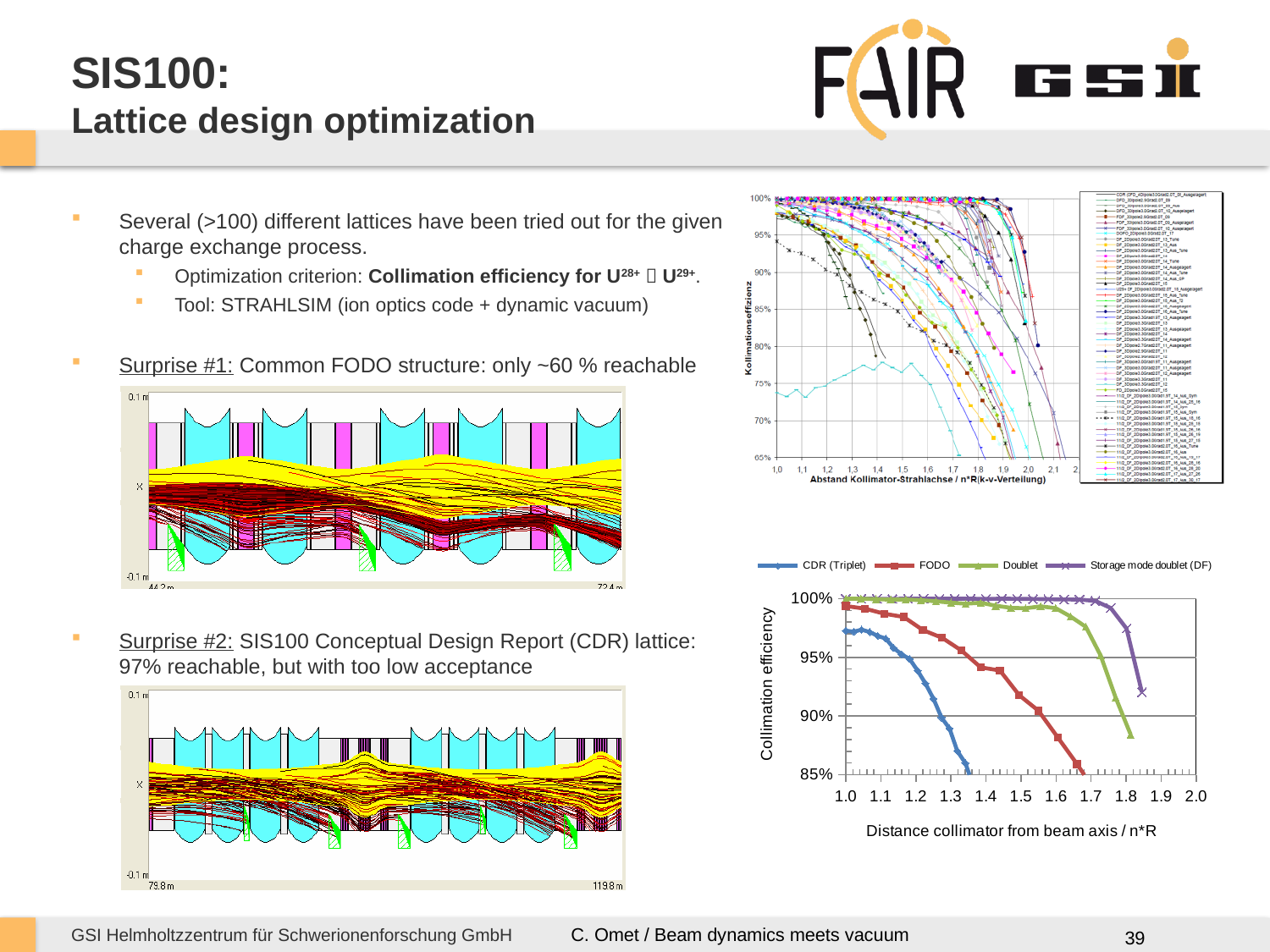
In the bottom-right chart, at a distance of 1.2, which series has the higher collimation efficiency, CDR (Triplet) or FODO? FODO In the bottom-right chart, is the collimation efficiency for FODO at a distance of 1.5 greater or less than 90%? greater In the bottom-right chart, is the collimation efficiency for Storage mode doublet (DF) at a distance of 1.8 greater or less than 95%? greater In the bottom-right chart, how many series does the legend list? 4 In the bottom-right chart, do the collimation efficiency values rise or fall as the distance from the beam axis increases? fall In the bottom-right chart, at a distance of 1.5, which series has the higher collimation efficiency, FODO or Doublet? Doublet In the bottom-right chart, is the collimation efficiency for CDR (Triplet) at a distance of 1.3 greater or less than 90%? less In the bottom-right chart, which series has the lowest collimation efficiency at a distance of 1.3? CDR (Triplet) What is the y-axis label of the bottom-right chart? Collimation efficiency What is the x-axis label of the bottom-right chart? Distance collimator from beam axis / n*R What kind of chart is the bottom-right chart with the legend CDR (Triplet), FODO, Doublet and Storage mode doublet (DF)? line chart